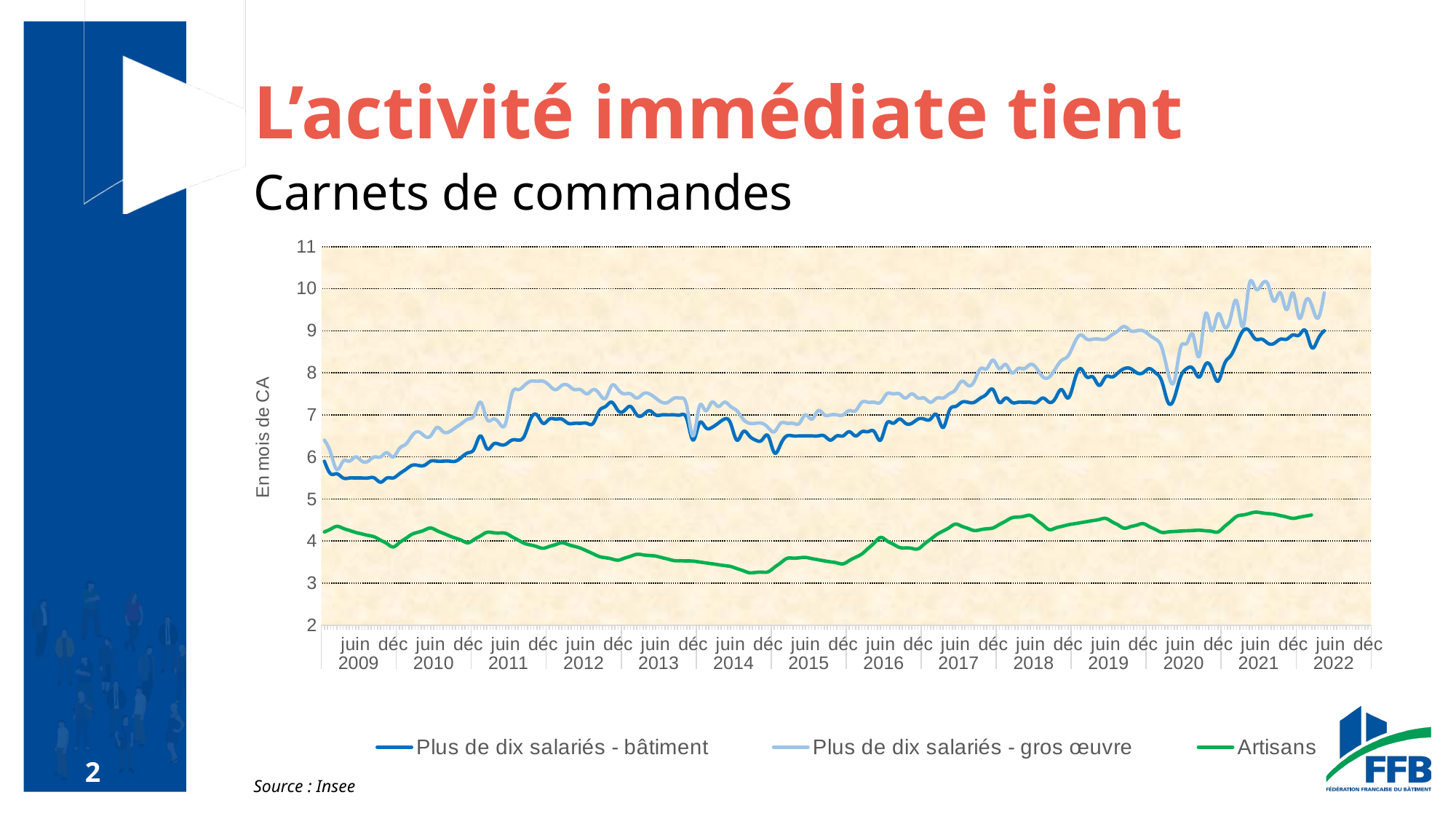
Is the value for Plus de dix salariés - bâtiment in juin 2009 greater or less than 7? less What is the label of the vertical axis? En mois de CA Which series reaches the highest values in 2021? Plus de dix salariés - gros œuvre Does the Plus de dix salariés - bâtiment series rise or fall overall between 2009 and 2022? rise Does the Artisans series rise or fall between 2011 and 2014? fall Which series is drawn in green in the legend? Artisans How many series does the legend list? 3 Which series has the lowest values throughout the whole period? Artisans What kind of chart is shown on the slide? line chart